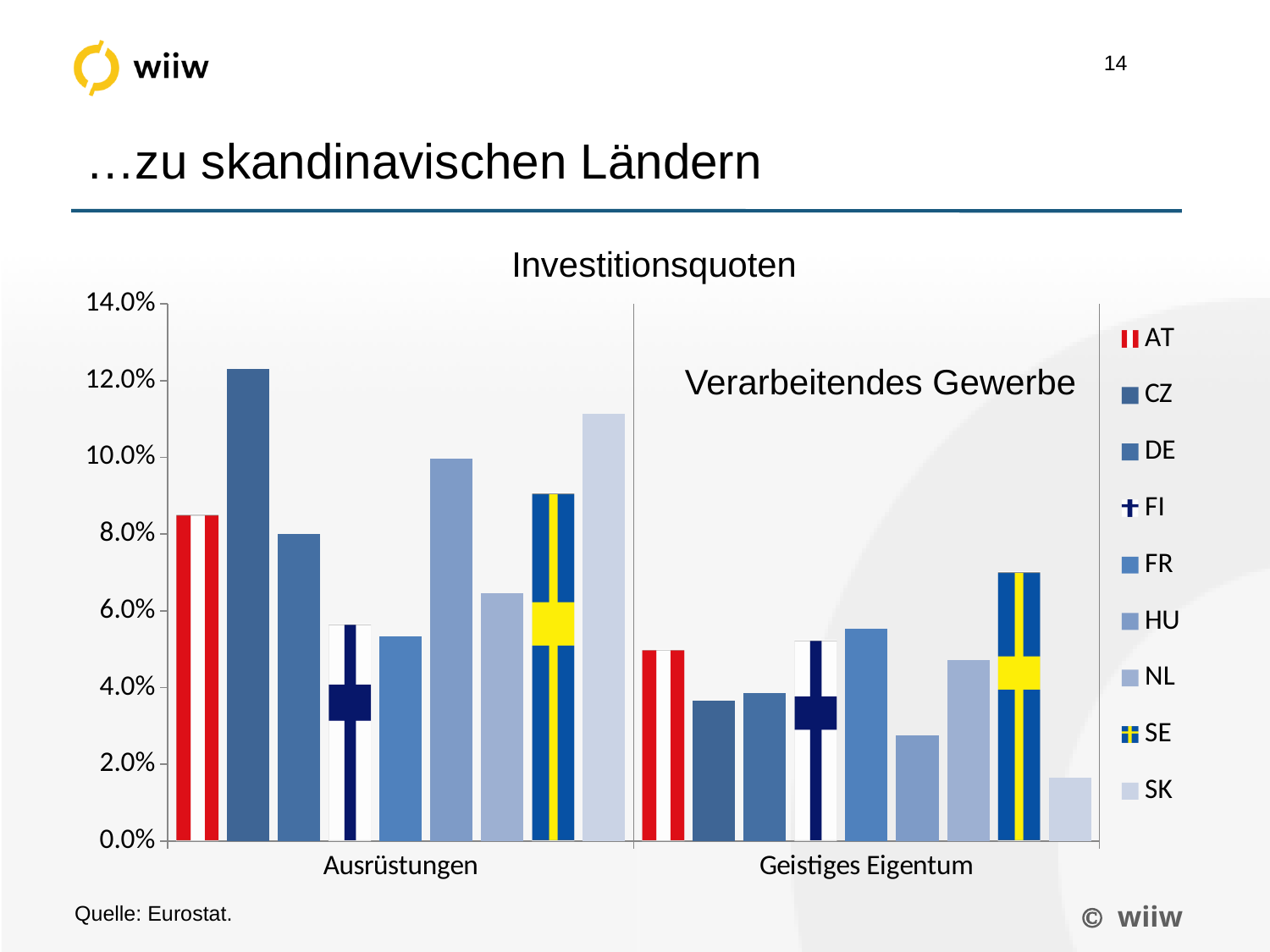
What kind of chart is shown on the slide? bar chart Which is larger for Geistiges Eigentum: the value for SE or the value for HU? SE Which country has the lowest value for Geistiges Eigentum? SK Which country has the highest value for Ausrüstungen? CZ What is the title of the chart? Investitionsquoten Which country has the highest value for Geistiges Eigentum? SE Is the value for HU in Ausrüstungen greater or less than 8.0%? greater Is the value for SK in Geistiges Eigentum greater or less than 2.0%? less How many series does the legend list? 9 Is the value for CZ in Ausrüstungen greater or less than 12.0%? greater How many categories are shown on the x axis? 2 Which is larger: the value for SK in Ausrüstungen or the value for SK in Geistiges Eigentum? Ausrüstungen